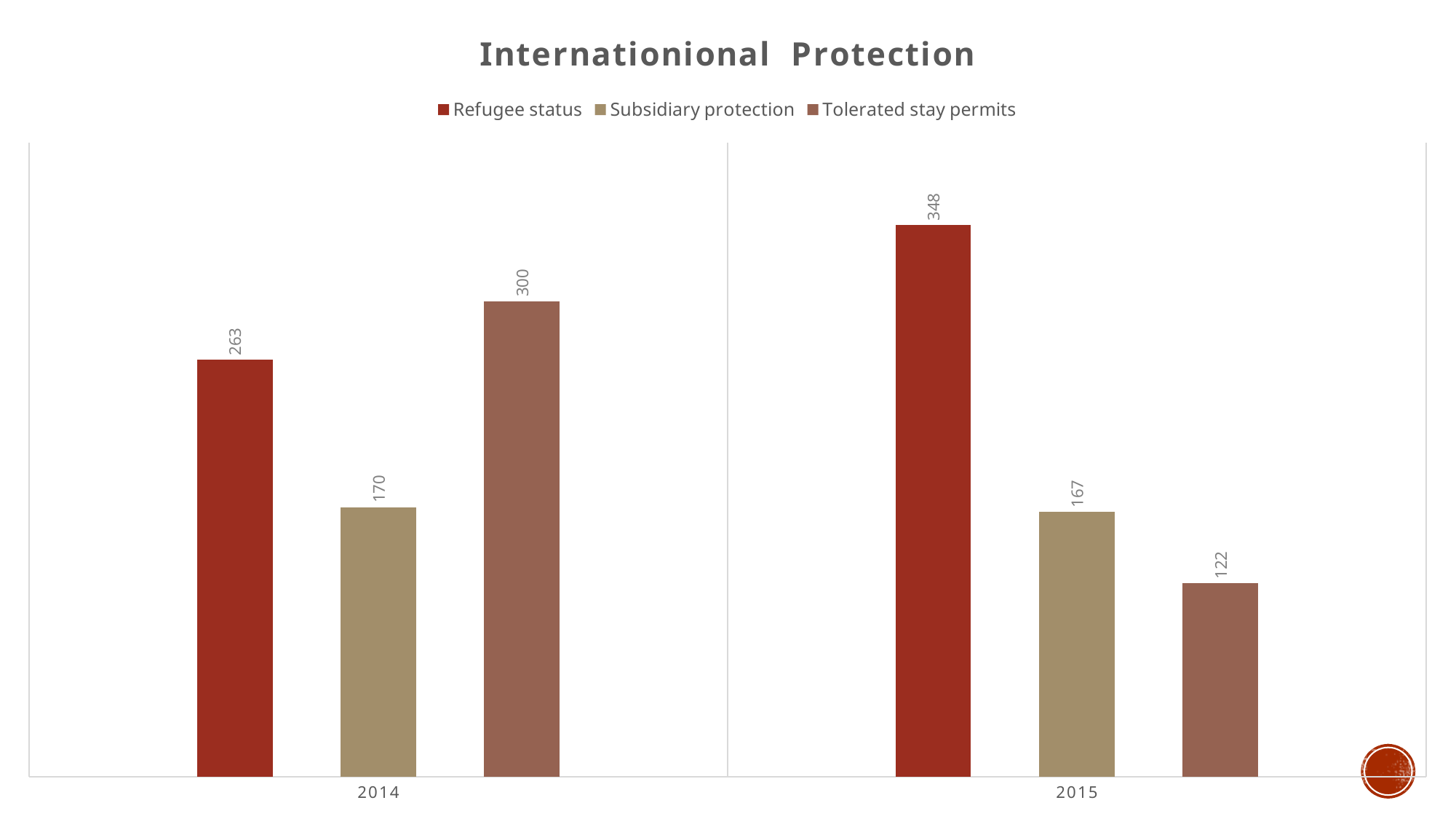
What is the value for Tolerated stay permits in 2015? 122 What is the value for Refugee status in 2014? 263 What is the value for Subsidiary protection in 2015? 167 Does the value for Tolerated stay permits rise or fall from 2014 to 2015? Fall Which series has the lowest value in 2014? Subsidiary protection Which series has the highest value in 2015? Refugee status How many series does the legend list? 3 Which is larger in 2014: Refugee status or Tolerated stay permits? Tolerated stay permits What kind of chart is shown on the slide? Bar chart What is the difference between Tolerated stay permits in 2014 and in 2015? 178 How many year categories are shown on the x axis? 2 What is the difference between Refugee status in 2015 and Refugee status in 2014? 85